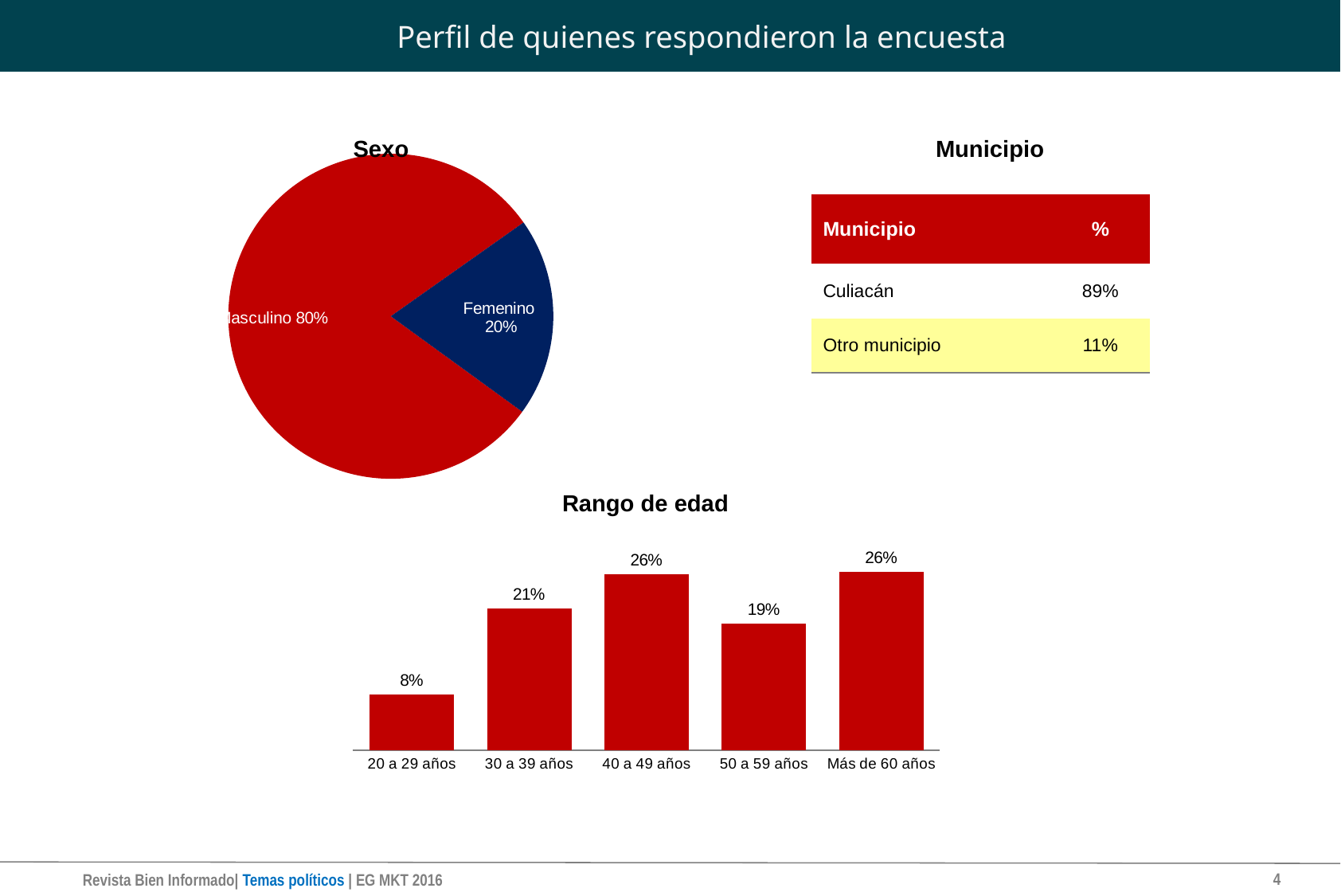
In the "Rango de edad" chart, what is the value for 50 a 59 años? 19% What kind of chart is the "Sexo" chart? Pie chart In the "Sexo" chart, what share of respondents is Femenino? 20% How many age ranges are shown in the "Rango de edad" chart? 5 In the "Rango de edad" chart, which is larger, 30 a 39 años or 50 a 59 años? 30 a 39 años What kind of chart is the "Rango de edad" chart? Bar chart In the "Rango de edad" chart, what is the value for Más de 60 años? 26% In the "Rango de edad" chart, what is the value for 30 a 39 años? 21% In the "Rango de edad" chart, what is the difference between 40 a 49 años and 20 a 29 años? 18% In the "Sexo" chart, which slice is larger, Masculino or Femenino? Masculino In the "Rango de edad" chart, which age range has the lowest value? 20 a 29 años In the "Sexo" chart, what share of respondents is Masculino? 80%